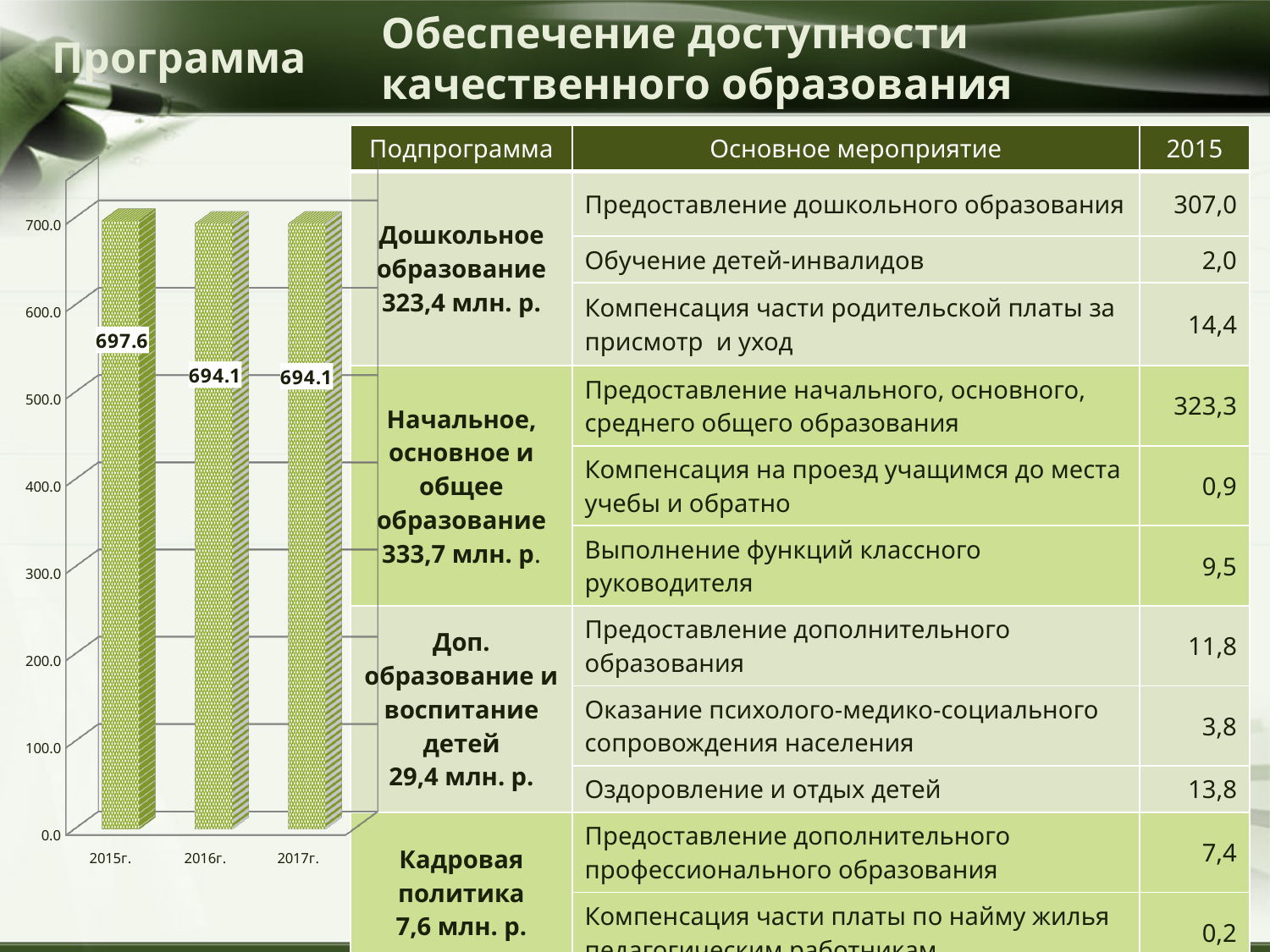
What is the value shown for 2016г. in the bar chart? 694.1 Is the value for 2016г. in the bar chart greater or less than 600.0? greater What kind of chart is shown on the left of the slide? bar chart How many bars are shown in the bar chart? 3 Which year has the highest value in the bar chart? 2015г. What is the value shown for 2015г. in the bar chart? 697.6 What is the value shown for 2017г. in the bar chart? 694.1 Does the value in the bar chart rise or fall from 2015г. to 2016г.? fall What is the highest tick value shown on the vertical axis of the bar chart? 700.0 What is the difference between the values for 2015г. and 2016г. in the bar chart? 3.5 Is the value for 2017г. in the bar chart greater or less than 700.0? less Which is larger in the bar chart, the value for 2015г. or the value for 2017г.? 2015г.